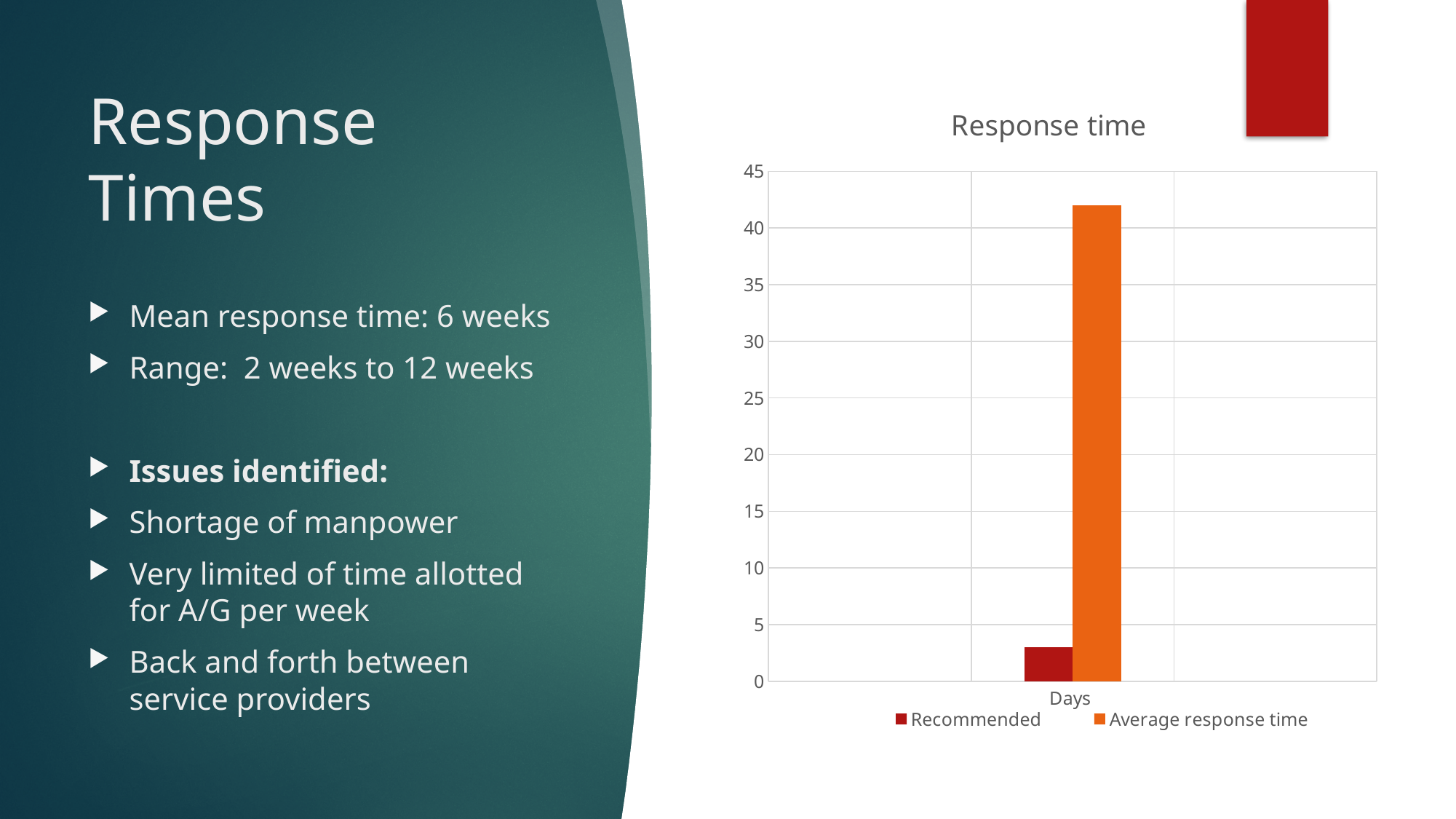
What is the label of the category on the x axis? Days What is the title of the chart? Response time Which series has the lowest value in the chart? Recommended Which series has the highest value in the chart? Average response time Is the value for Recommended greater or less than 10? less Is the value for Average response time greater or less than 45? less Which series has the taller bar, Recommended or Average response time? Average response time Is the value for Average response time greater or less than 40? greater How many categories are shown on the x axis of the chart? 1 How many series does the chart legend list? 2 What kind of chart is shown on the slide? bar chart